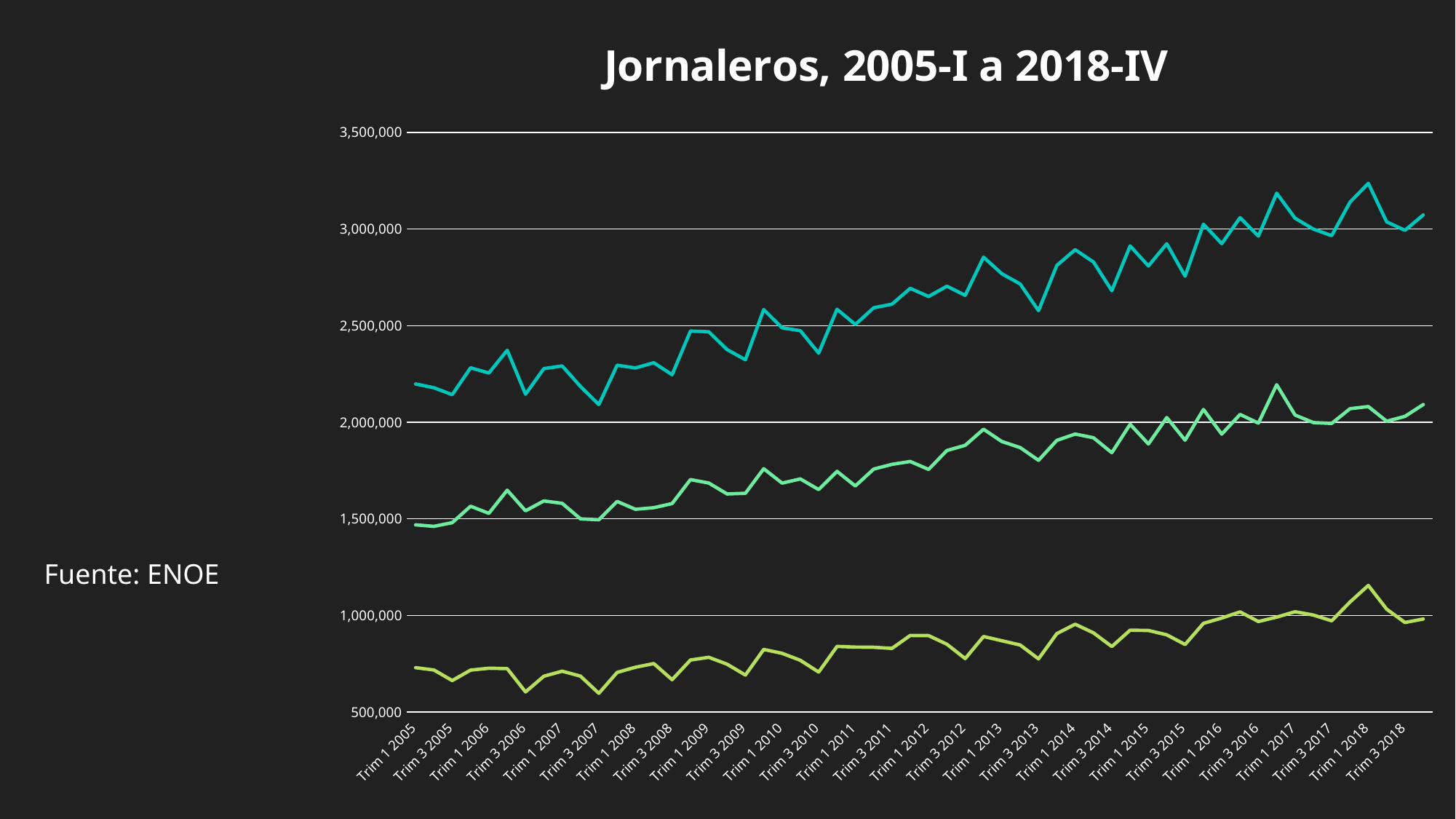
Is the value of the bottom (yellow-green) line at Trim 1 2005 greater or less than 1,000,000? less How many lines are plotted on the chart? 3 Is the value of the middle (green) line at Trim 1 2005 greater or less than 1,500,000? less Is the value of the bottom (yellow-green) line at Trim 1 2018 greater or less than 1,000,000? greater Overall, do the values of the top (teal) line rise or fall from Trim 1 2005 to Trim 3 2018? rise At which quarter does the top (teal) line reach its highest point? Trim 1 2018 What is the title of the chart? Jornaleros, 2005-I a 2018-IV What kind of chart is shown on the slide? line chart What source is cited for the chart? ENOE